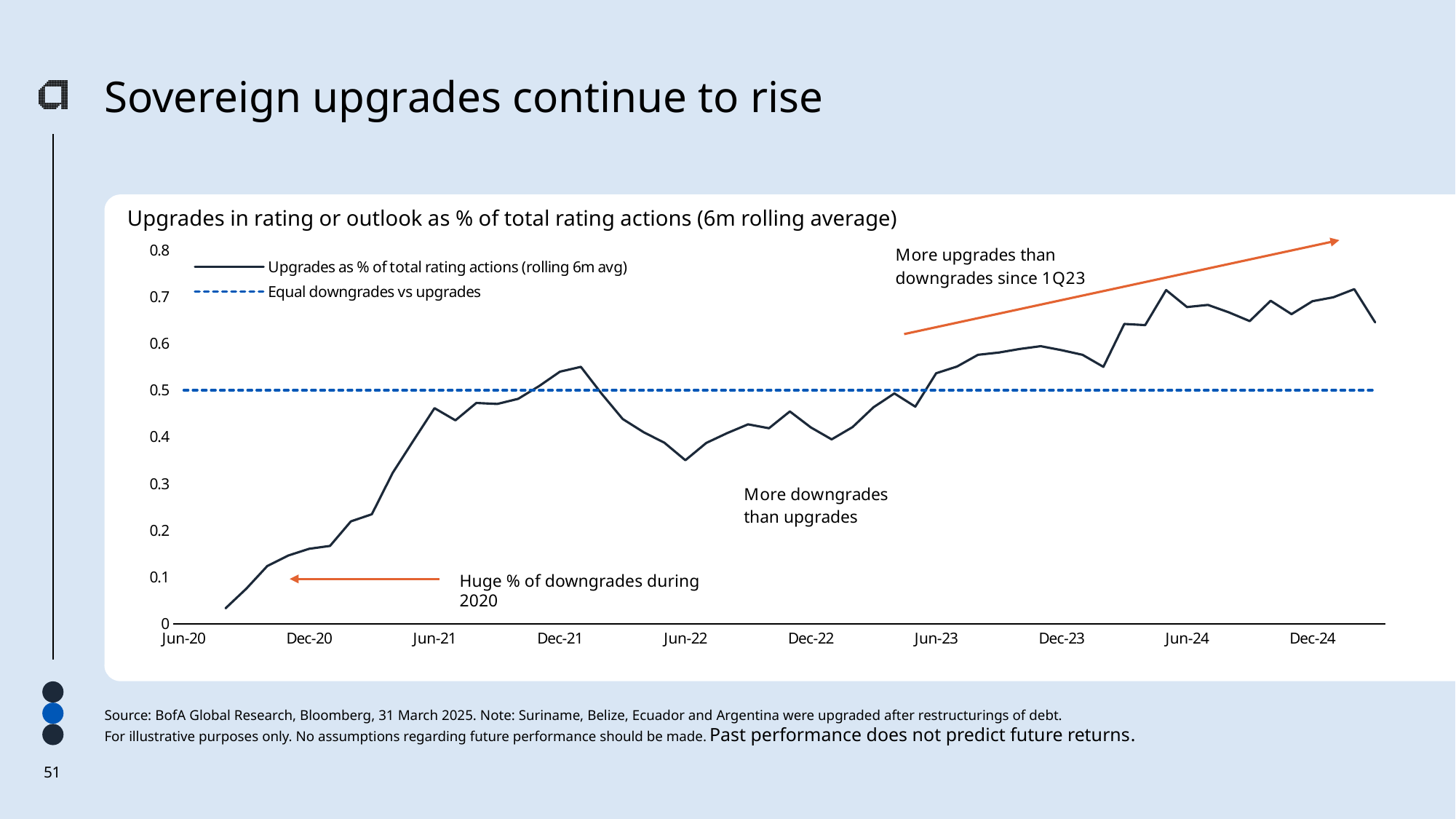
What does the annotation near the top right of the chart say? More upgrades than downgrades since 1Q23 What kind of chart is shown on the slide? line chart Does the upgrades line rise or fall between Jun-20 and Jun-21? rise How many series does the chart legend list? 2 Is the value of upgrades as % of total rating actions at Dec-20 greater or less than 0.2? less Is the value of upgrades as % of total rating actions at Jun-24 greater or less than 0.6? greater Which is larger, the value of upgrades as % of total rating actions at Jun-24 or at Jun-22? Jun-24 Is the value of upgrades as % of total rating actions at Jun-22 greater or less than 0.4? less At what level is the dashed 'Equal downgrades vs upgrades' line drawn? 0.5 How many date labels are shown on the x axis? 10 What is the title of the chart? Upgrades in rating or outlook as % of total rating actions (6m rolling average)